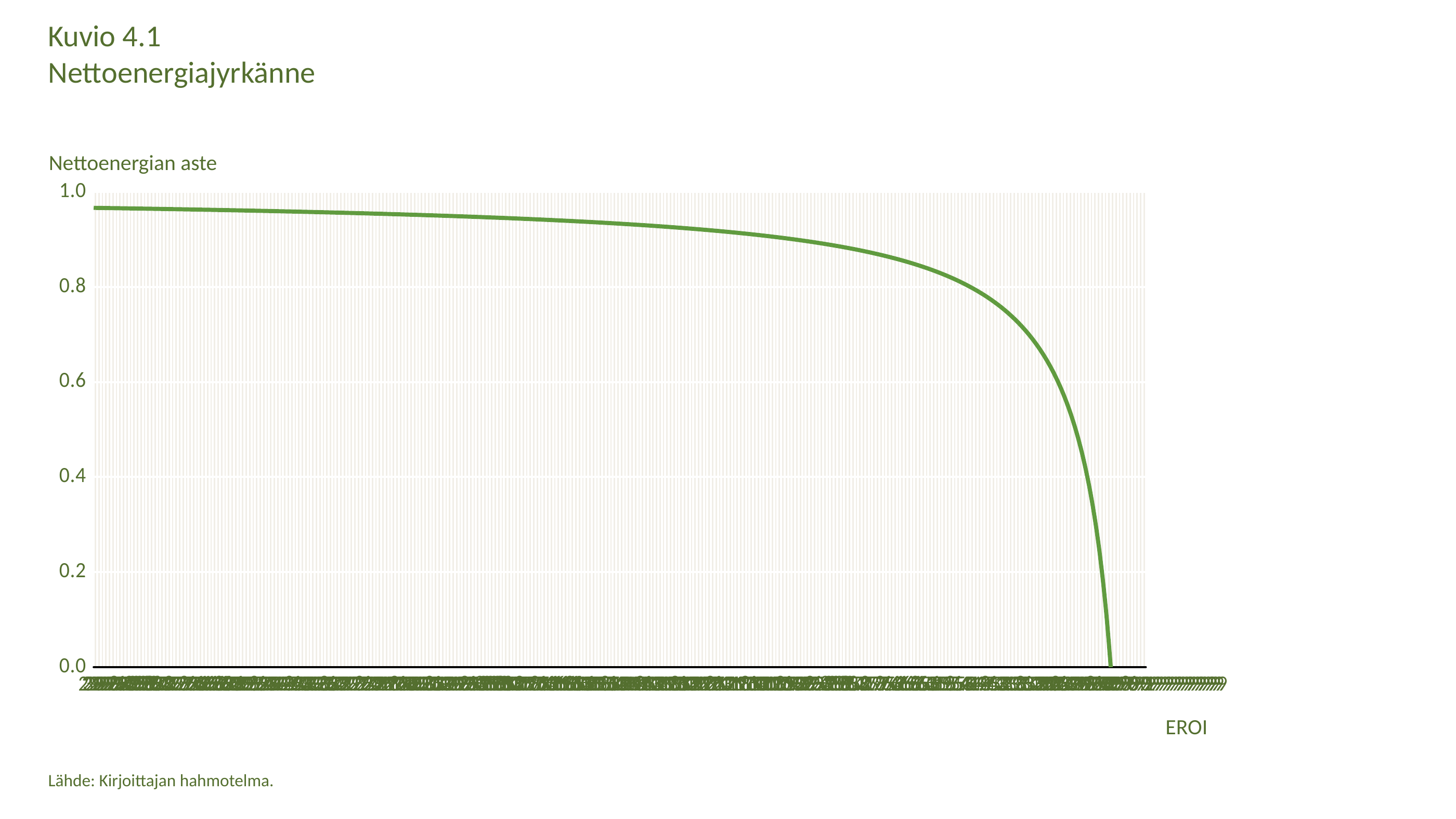
Does the plotted line rise or fall as it moves from left to right along the x axis? fall Is the value of the line at the left end of the chart greater or less than 0.8? greater Is the value of the line at the far right end of the chart greater or less than 0.2? less What is the highest tick value shown on the y axis? 1.0 What kind of chart is shown on the slide? line chart What label is shown on the x axis of the chart? EROI What is the lowest tick value shown on the y axis? 0.0 What is the title of the chart? Kuvio 4.1 Nettoenergiajyrkänne